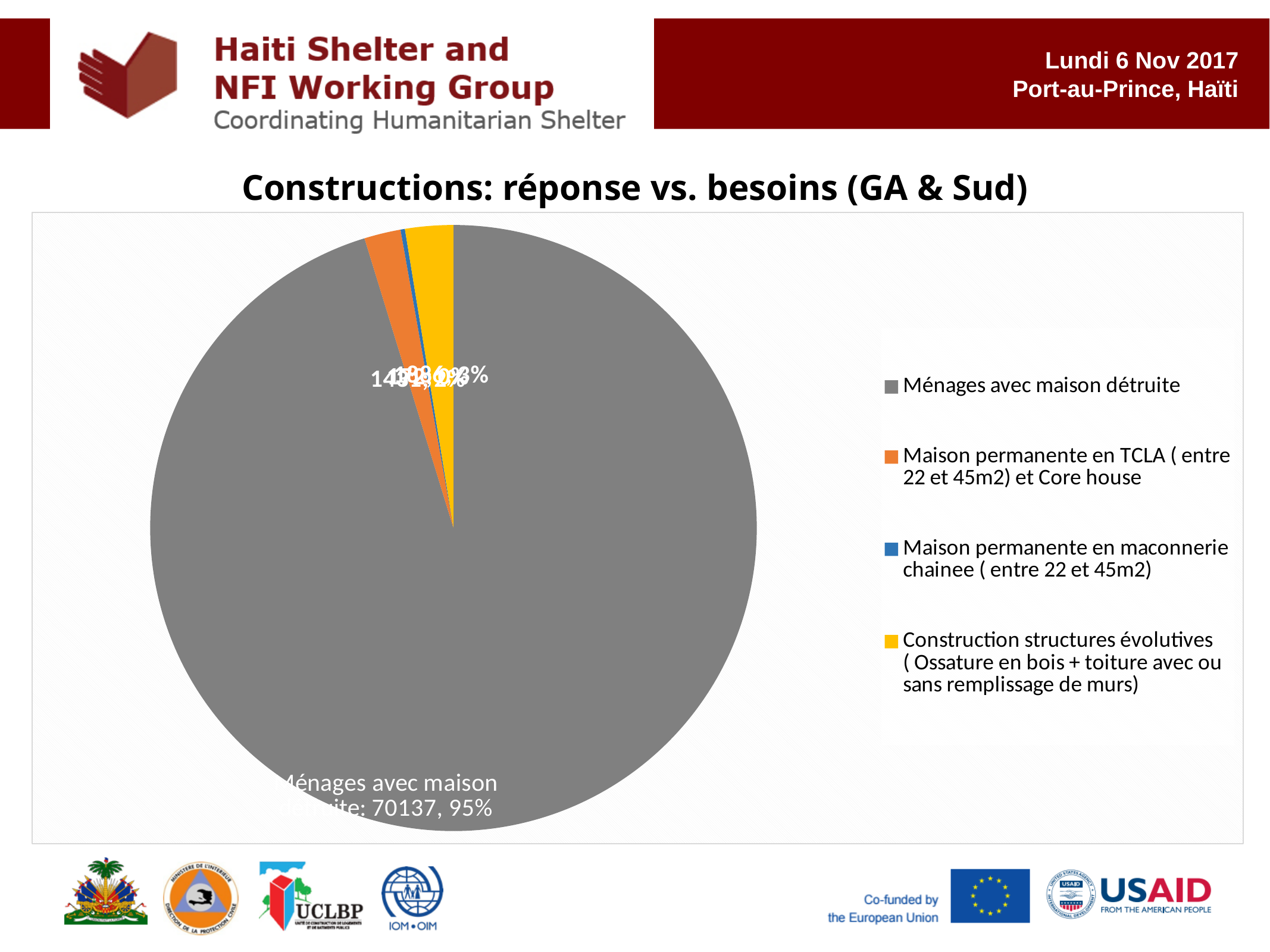
Which is larger: the slice for Ménages avec maison détruite or the slice for Maison permanente en TCLA ( entre 22 et 45m2) et Core house? Ménages avec maison détruite What is the value shown for Ménages avec maison détruite? 70137 What is the title of the slide's chart? Constructions: réponse vs. besoins (GA & Sud) How many entries does the legend list? 4 What colour is the slice for Ménages avec maison détruite? grey How many slices does the pie chart have? 4 What kind of chart is shown on the slide? pie chart Which category has the largest slice of the pie? Ménages avec maison détruite Which category has the smallest slice of the pie? Maison permanente en maconnerie chainee ( entre 22 et 45m2) What share of the pie does Ménages avec maison détruite represent? 95% Which is larger: the slice for Construction structures évolutives or the slice for Maison permanente en maconnerie chainee? Construction structures évolutives